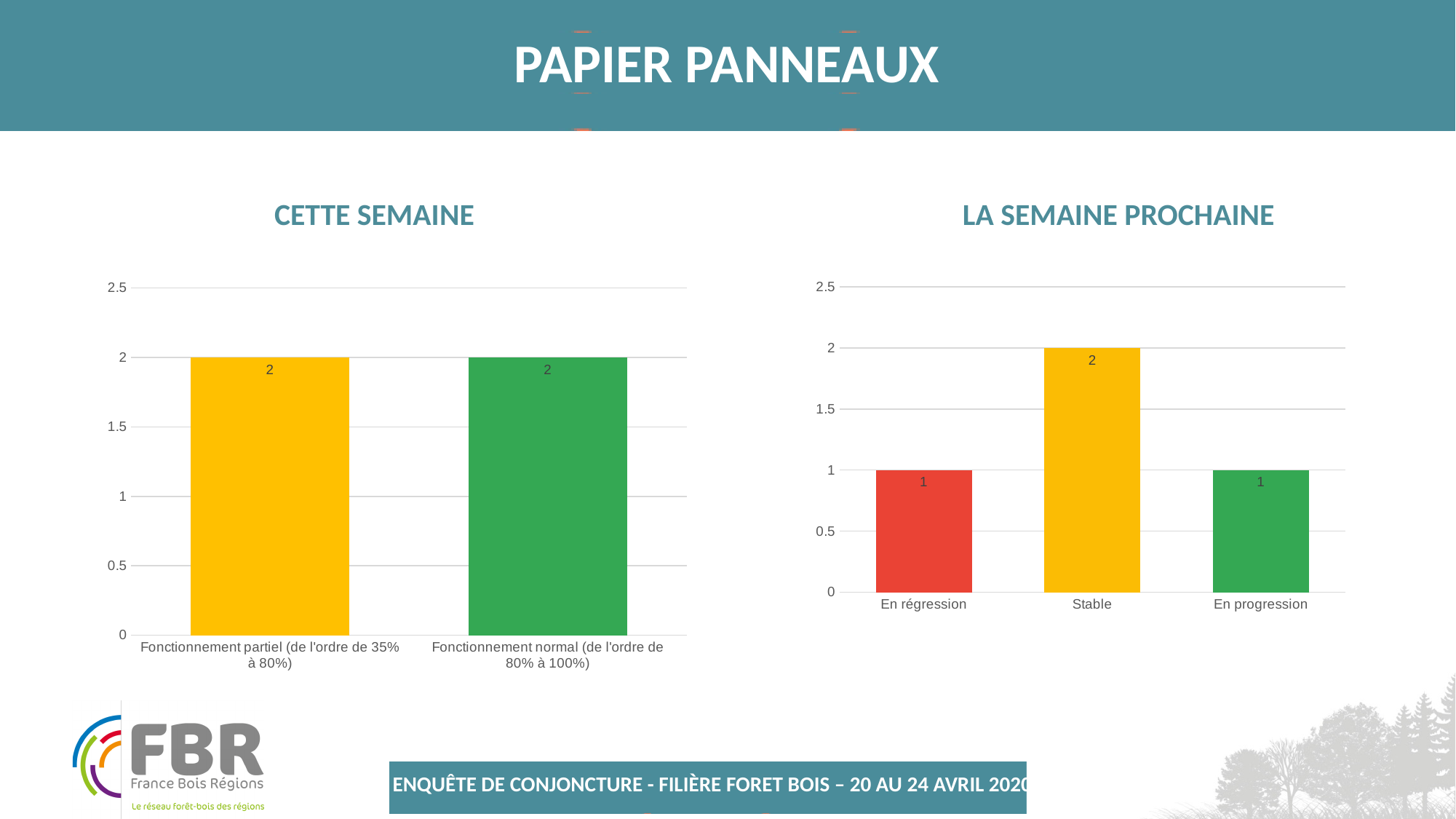
In the 'CETTE SEMAINE' chart, what is the difference between the values for 'Fonctionnement partiel' and 'Fonctionnement normal'? 0 What type of chart is the 'CETTE SEMAINE' chart? Bar chart In the 'CETTE SEMAINE' chart, how many categories are shown? 2 In the 'LA SEMAINE PROCHAINE' chart, which category has the highest value? Stable In the 'LA SEMAINE PROCHAINE' chart, what is the value for 'En régression'? 1 In the 'LA SEMAINE PROCHAINE' chart, how many categories are shown? 3 In the 'LA SEMAINE PROCHAINE' chart, what is the value for 'En progression'? 1 In the 'CETTE SEMAINE' chart, what is the value for 'Fonctionnement partiel (de l'ordre de 35% à 80%)'? 2 In the 'CETTE SEMAINE' chart, what is the value for 'Fonctionnement normal (de l'ordre de 80% à 100%)'? 2 In the 'LA SEMAINE PROCHAINE' chart, which is larger, the value for 'Stable' or the value for 'En progression'? Stable In the 'LA SEMAINE PROCHAINE' chart, what is the difference between the values for 'Stable' and 'En régression'? 1 In the 'LA SEMAINE PROCHAINE' chart, what is the value for 'Stable'? 2